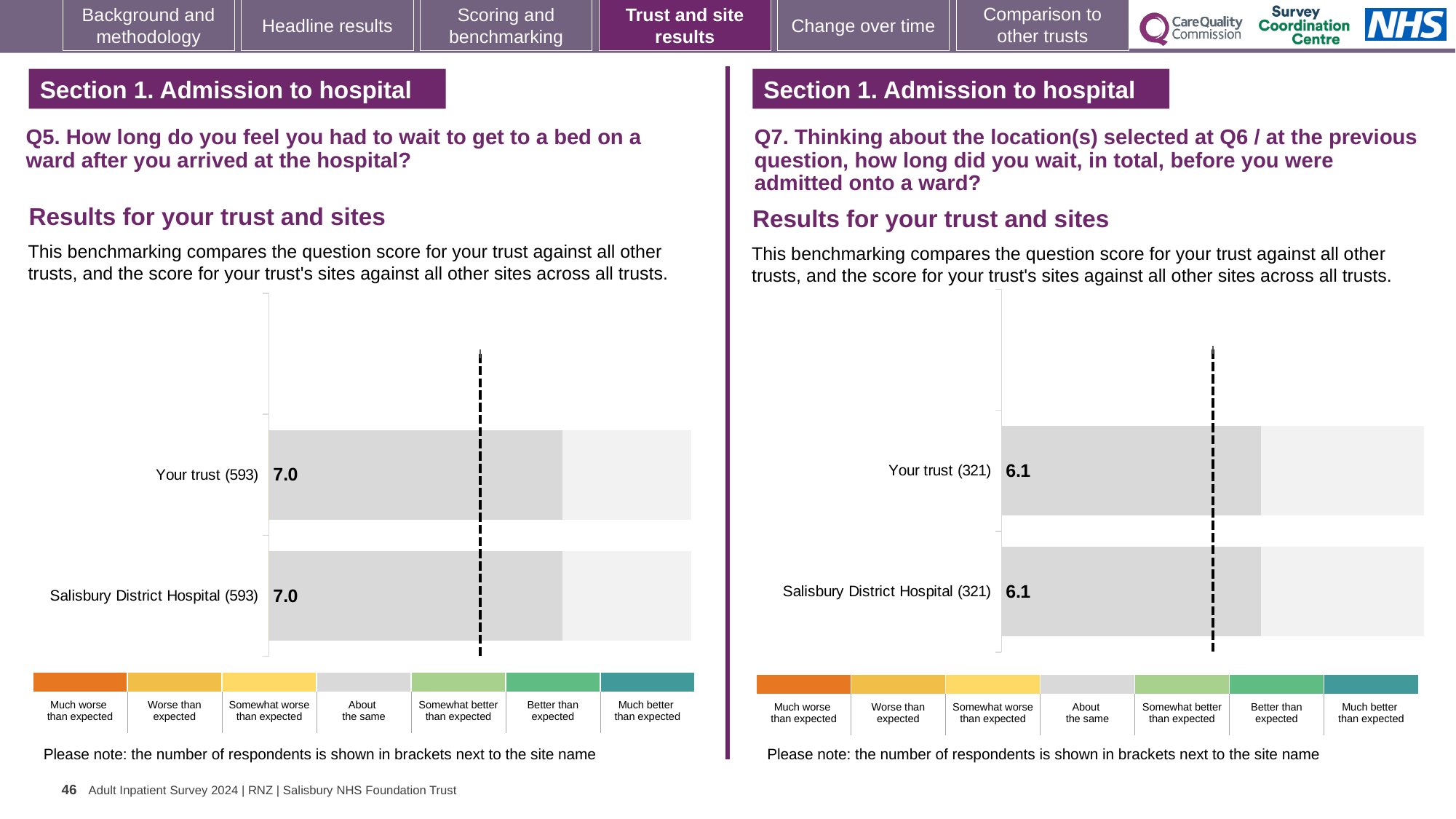
In the Q7 chart on the right, how many bars are plotted? 2 In the Q7 chart on the right, what is the score for Salisbury District Hospital? 6.1 What is the difference between the Your trust score in the Q5 chart on the left and the Your trust score in the Q7 chart on the right? 0.9 In the Q7 chart on the right, what is the score for Your trust? 6.1 In the Q5 chart on the left, how many respondents are shown in brackets next to Your trust? 593 In the Q5 chart on the left, how many bars are plotted? 2 In the Q5 chart on the left, what is the difference between the score for Your trust and the score for Salisbury District Hospital? 0.0 What kind of chart is used for the Q5 results on the left? Bar chart Which is larger: the Your trust score in the Q5 chart on the left or the Your trust score in the Q7 chart on the right? Q5 chart (7.0) In the Q5 chart on the left, what is the score for Salisbury District Hospital? 7.0 In the Q5 chart on the left, what is the score for Your trust? 7.0 In the Q7 chart on the right, how many respondents are shown in brackets next to Salisbury District Hospital? 321